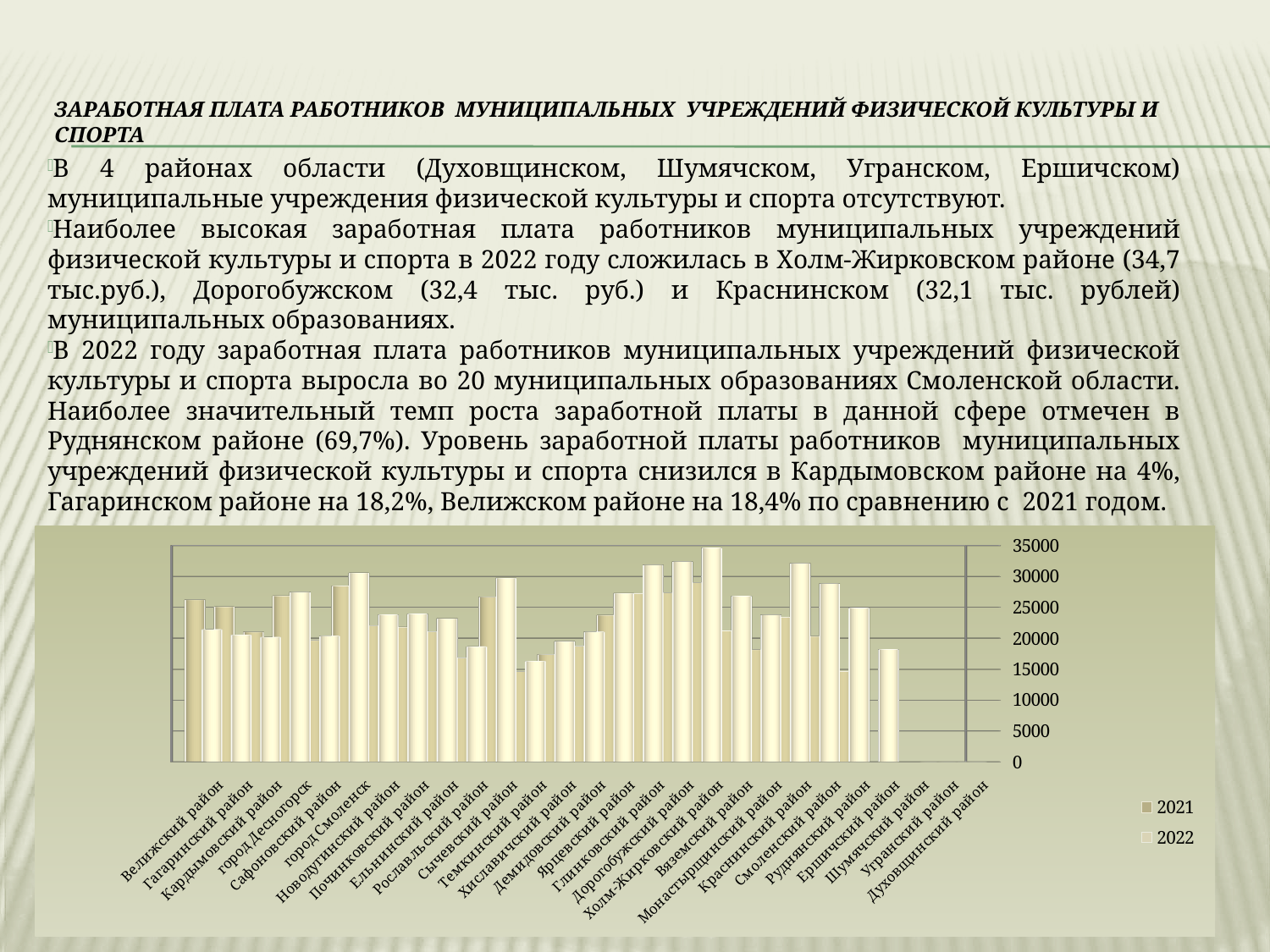
What kind of chart is shown on the slide? bar chart Is the 2021 value for Темкинский район greater or less than 20000? less Is the 2022 value for Вяземский район greater or less than 25000? greater Is the 2022 value for Холм-Жирковский район greater or less than 30000? greater Which district has the highest 2022 bar in the chart? Холм-Жирковский район How many series does the chart legend list? 2 For Руднянский район, which year has the larger bar, 2021 or 2022? 2022 What are the two series named in the chart legend? 2021 and 2022 Which is larger: the 2022 value for Холм-Жирковский район or the 2022 value for Темкинский район? Холм-Жирковский район For Велижский район, which year has the larger bar, 2021 or 2022? 2021